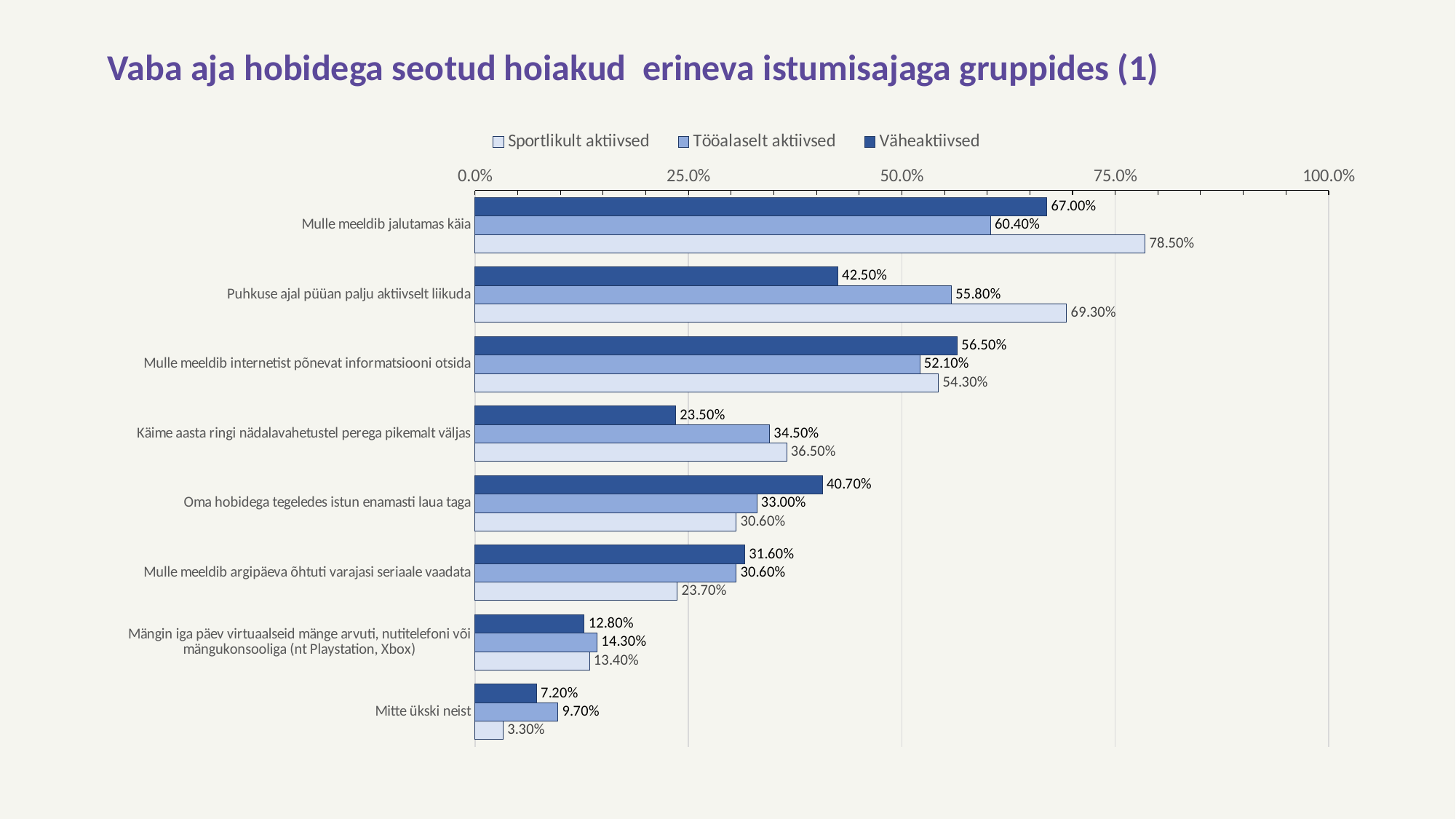
How many categories are shown on the chart? 8 Which category has the highest value for Väheaktiivsed? Mulle meeldib jalutamas käia Which series is shown with the darkest blue bars? Väheaktiivsed What is the value for Väheaktiivsed for "Puhkuse ajal püüan palju aktiivselt liikuda"? 42.50% For "Oma hobidega tegeledes istun enamasti laua taga", which series has the larger value: Väheaktiivsed or Sportlikult aktiivsed? Väheaktiivsed Which category has the lowest value for Sportlikult aktiivsed? Mitte ükski neist What is the difference between the Sportlikult aktiivsed and Väheaktiivsed values for "Puhkuse ajal püüan palju aktiivselt liikuda"? 26.80% What kind of chart is shown on the slide? Bar chart Is the value for Tööalaselt aktiivsed for "Mulle meeldib internetist põnevat informatsiooni otsida" greater or less than 50.0%? greater What is the value for Tööalaselt aktiivsed for "Mitte ükski neist"? 9.70% What is the value for Sportlikult aktiivsed for "Mulle meeldib jalutamas käia"? 78.50% How many series does the legend list? 3